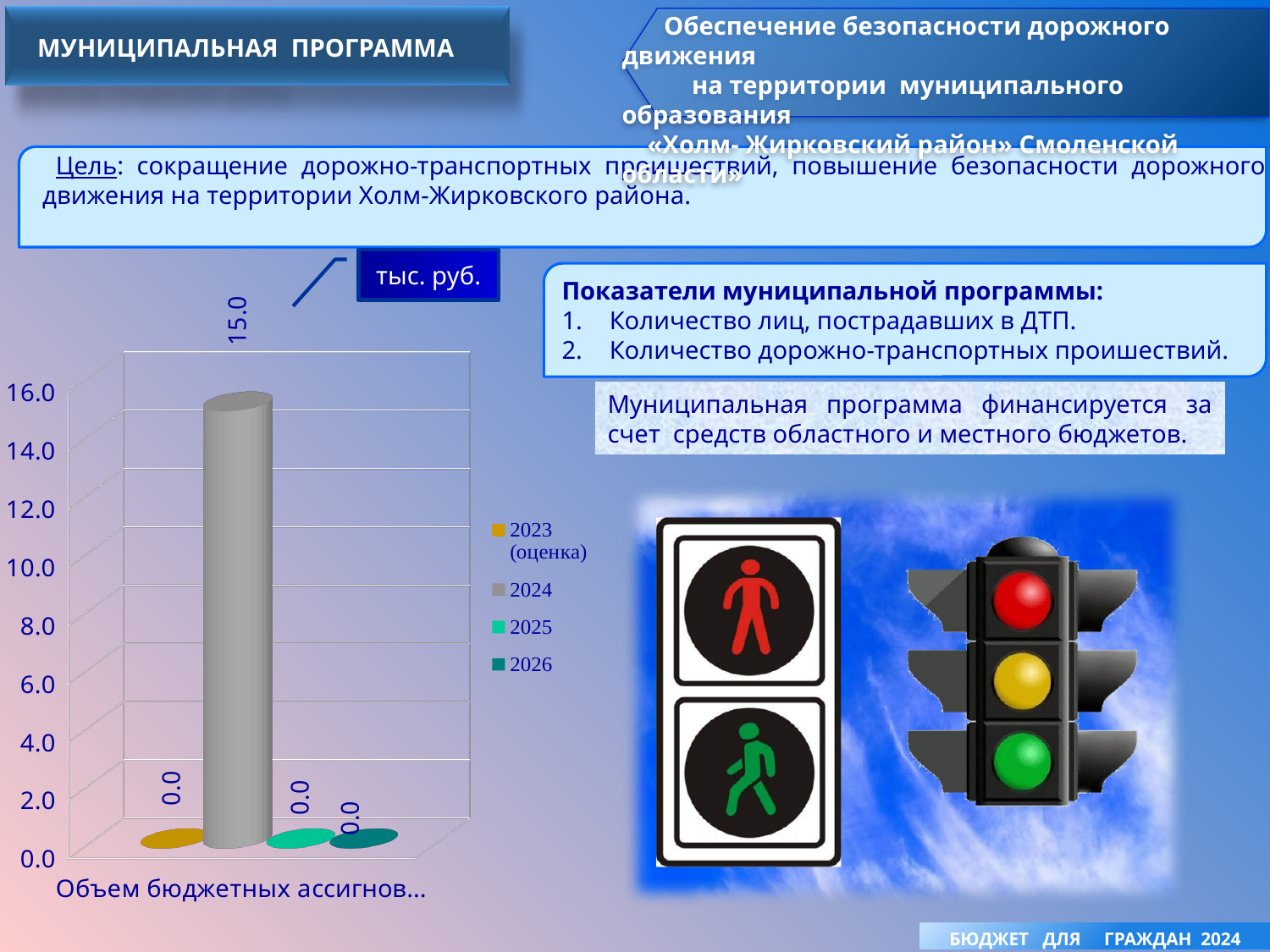
How many series does the chart legend list? 4 What is the value for 2023 (оценка) in the chart? 0.0 Which is larger, the value for 2024 or the value for 2023 (оценка)? 2024 Which series has the highest value in the chart? 2024 What unit of measurement is indicated for the chart values? тыс. руб. What is the difference between the values for 2024 and 2025? 15.0 Is the value for 2024 greater or less than 14.0? greater What is the value for 2025 in the chart? 0.0 What is the value for 2026 in the chart? 0.0 What is the value for 2024 in the chart? 15.0 What is the highest value shown on the chart's vertical axis? 16.0 What kind of chart is shown on the slide? bar chart